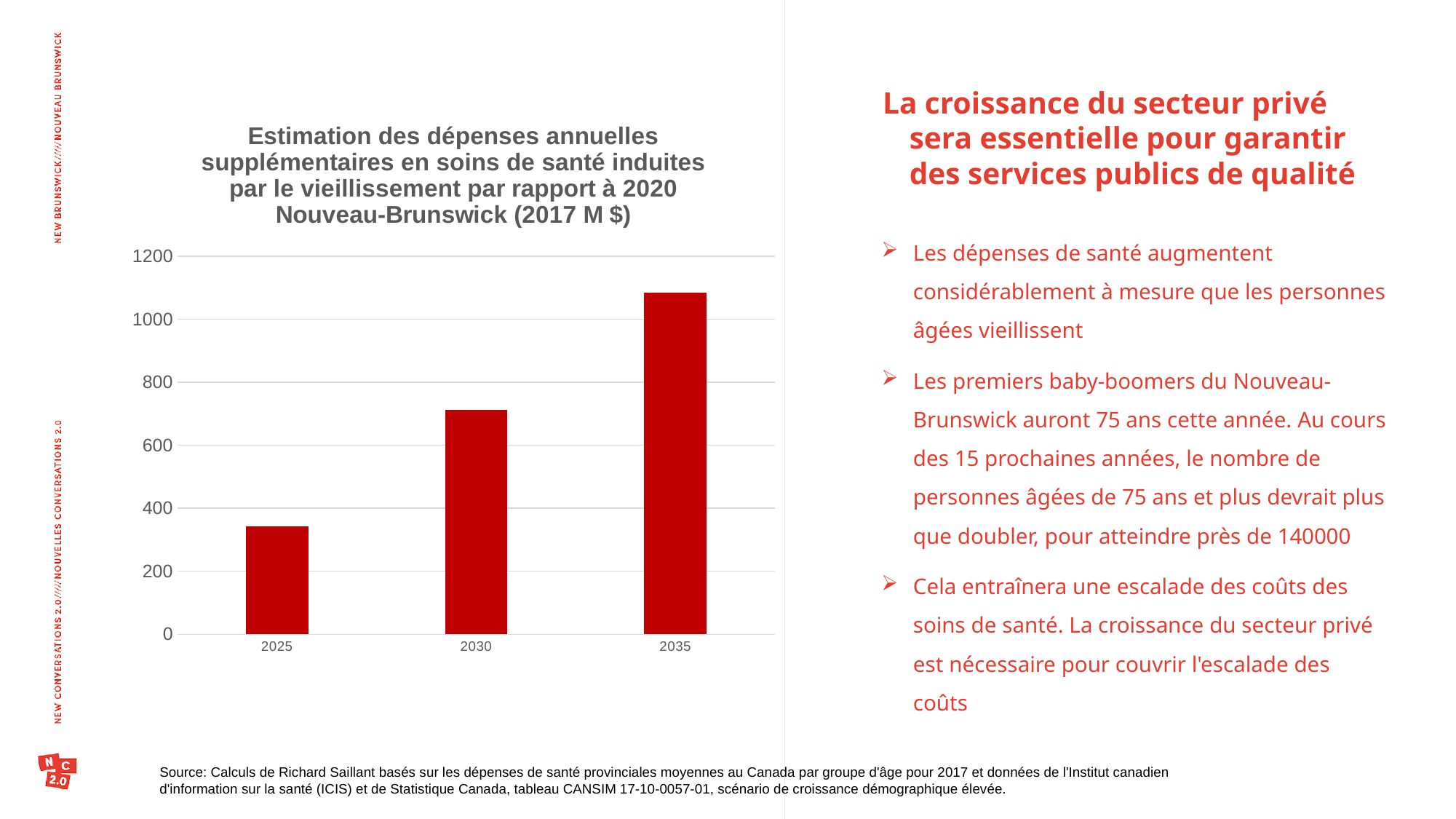
Which is larger, the value for 2030 or the value for 2035? 2035 Is the value for 2030 greater or less than 600? greater Which year has the highest estimated additional health spending? 2035 Which year has the lowest estimated additional health spending? 2025 What is the maximum value shown on the vertical axis of the chart? 1200 Do the values rise or fall from 2025 to 2035? rise Is the value for 2035 greater or less than 1000? greater What kind of chart is shown on the slide? bar chart In what unit are the chart values expressed, according to the chart title? 2017 M $ Is the value for 2025 greater or less than 200? greater How many bars (years) are plotted in the chart? 3